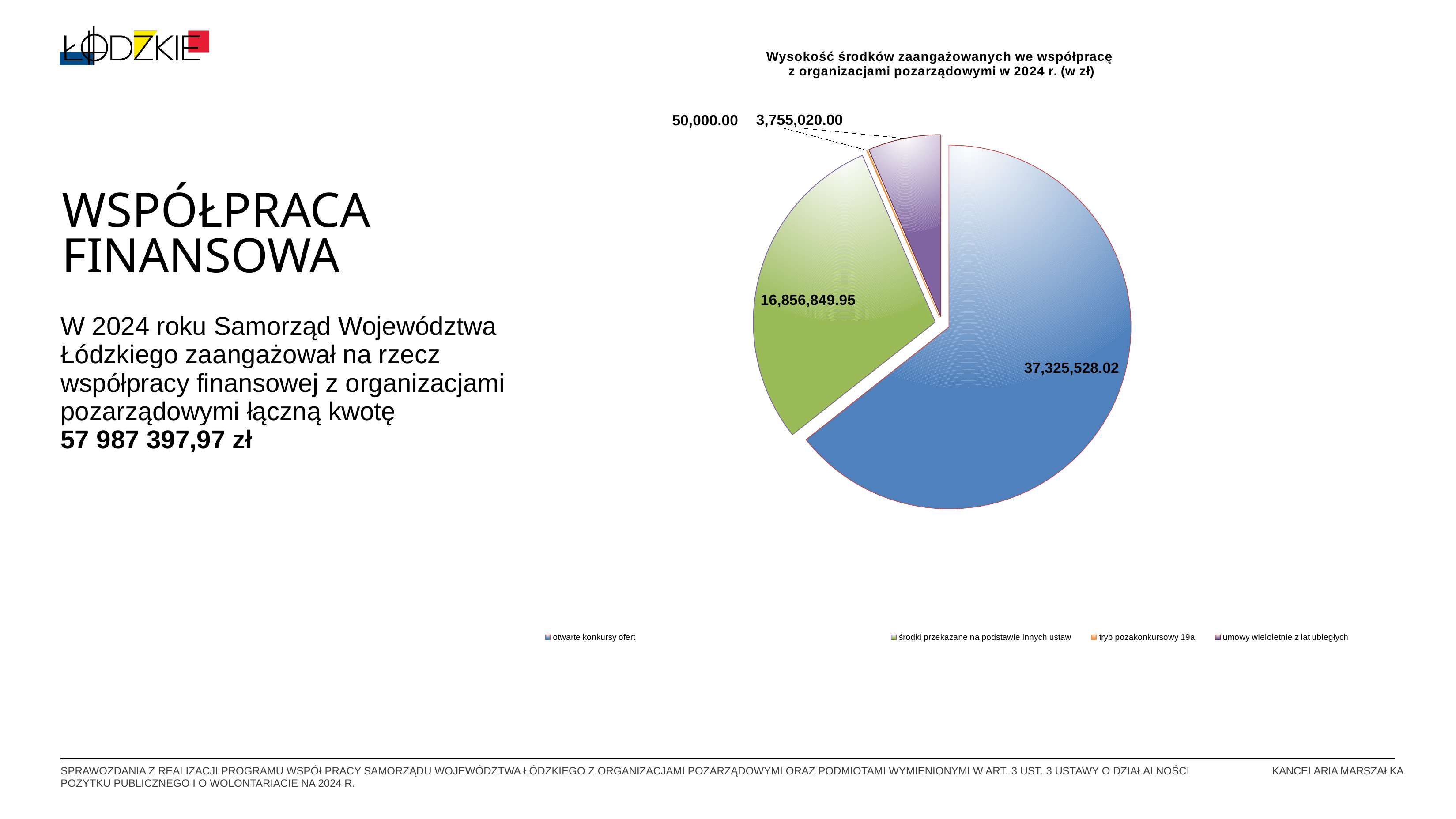
What is the title of the chart? Wysokość środków zaangażowanych we współpracę z organizacjami pozarządowymi w 2024 r. (w zł) Which is larger: "umowy wieloletnie z lat ubiegłych" or "tryb pozakonkursowy 19a"? umowy wieloletnie z lat ubiegłych How many slices does the pie chart have? 4 Which category has the smallest slice of the pie? tryb pozakonkursowy 19a What is the value for "umowy wieloletnie z lat ubiegłych"? 3,755,020.00 What is the value for "środki przekazane na podstawie innych ustaw"? 16,856,849.95 What is the value for "tryb pozakonkursowy 19a"? 50,000.00 How many entries does the chart legend list? 4 What kind of chart is shown on the slide? pie chart What is the difference between the values for "otwarte konkursy ofert" and "środki przekazane na podstawie innych ustaw"? 20,468,678.07 Which category has the largest slice of the pie? otwarte konkursy ofert What is the value for "otwarte konkursy ofert"? 37,325,528.02